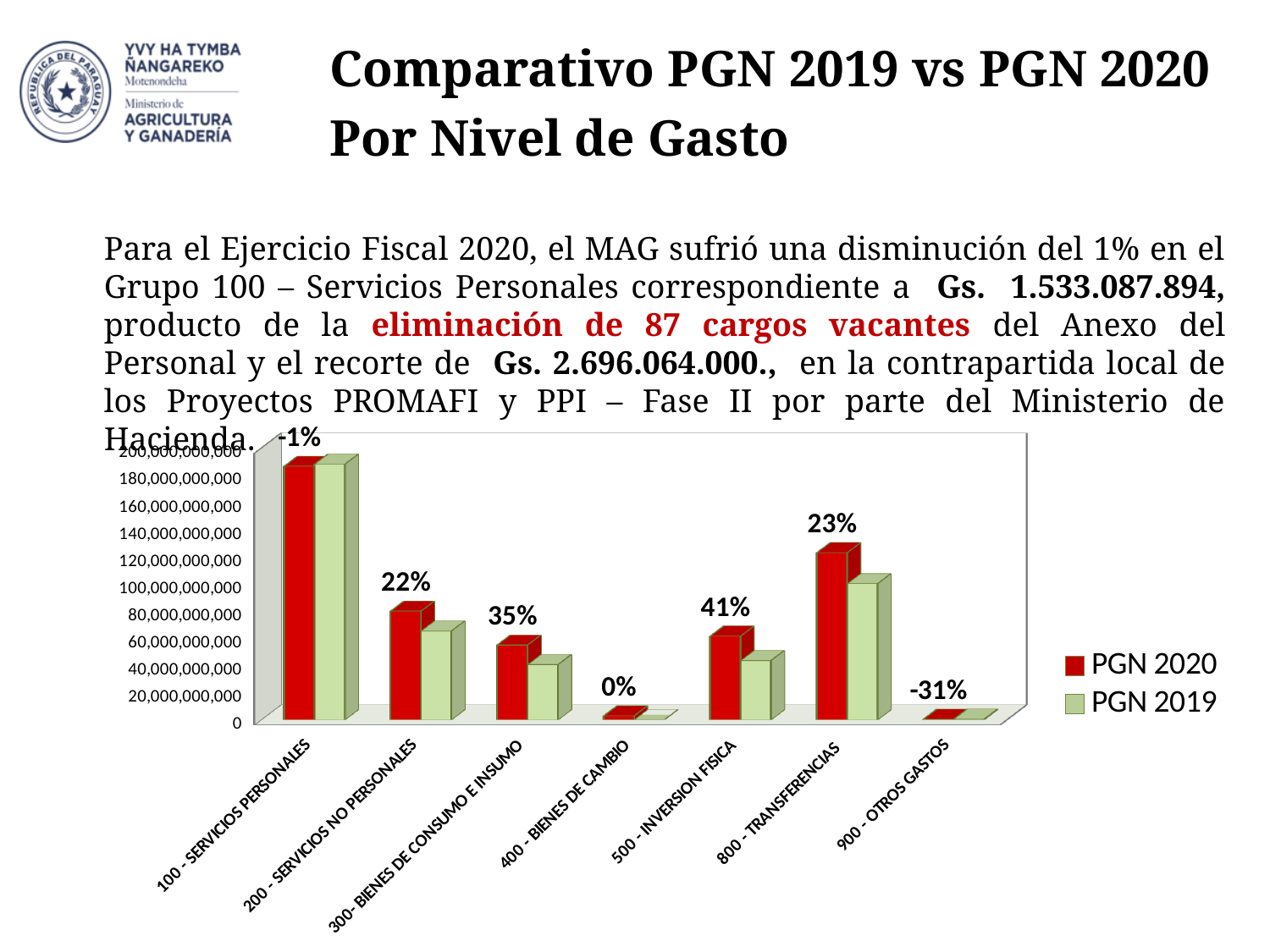
Which colour represents the PGN 2020 series in the chart legend? red For 800 - TRANSFERENCIAS, which series has the larger value, PGN 2020 or PGN 2019? PGN 2020 What percentage label is shown above the bars for 500 - INVERSION FISICA? 41% Is the PGN 2020 value for 100 - SERVICIOS PERSONALES greater or less than 180,000,000,000? greater Which category has the highest PGN 2020 value in the chart? 100 - SERVICIOS PERSONALES How many expense categories are shown along the x axis of the chart? 7 How many series does the chart legend list? 2 Is the PGN 2019 value for 500 - INVERSION FISICA greater or less than 60,000,000,000? less What percentage label is shown above the bars for 300 - BIENES DE CONSUMO E INSUMO? 35% What kind of chart is shown on the slide? bar chart Is the PGN 2020 value for 800 - TRANSFERENCIAS greater or less than 100,000,000,000? greater What percentage label is shown above the bars for 900 - OTROS GASTOS? -31%